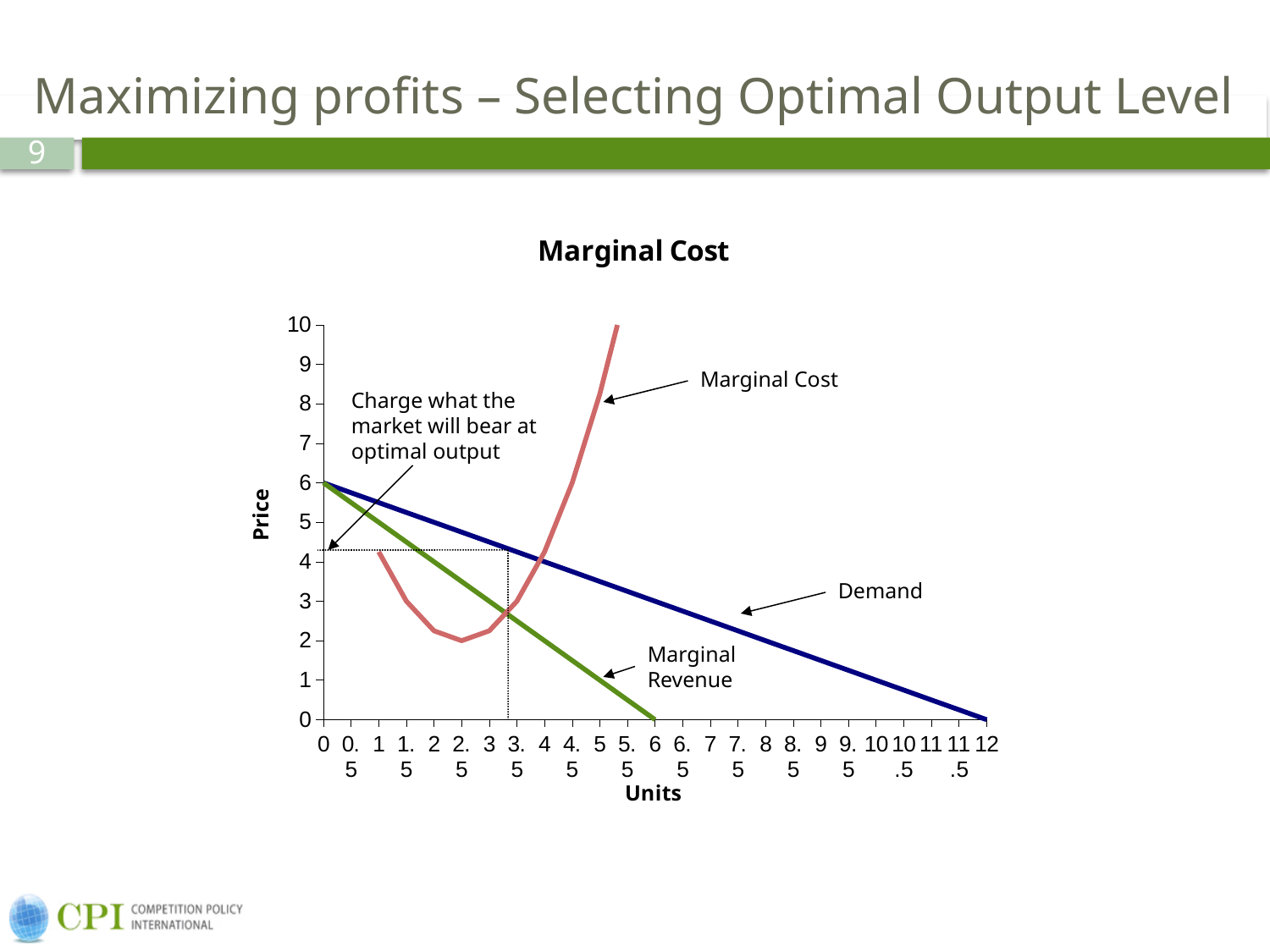
Does the Demand line rise or fall as Units increase? fall What is the label of the x axis of the chart? Units Is the Marginal Cost value at 2 Units greater or less than 3? less At how many Units does the Demand line reach a Price of 0? 12 What is the Price on the Demand line at 0 Units? 6 At 4 Units, which line has the higher Price: Demand or Marginal Revenue? Demand How many lines (series) are plotted on the chart? 3 What type of chart is shown on the slide? line chart At how many Units does the Marginal Revenue line reach a Price of 0? 6 What is the title of the chart? Marginal Cost Does the Marginal Revenue line rise or fall as Units increase? fall